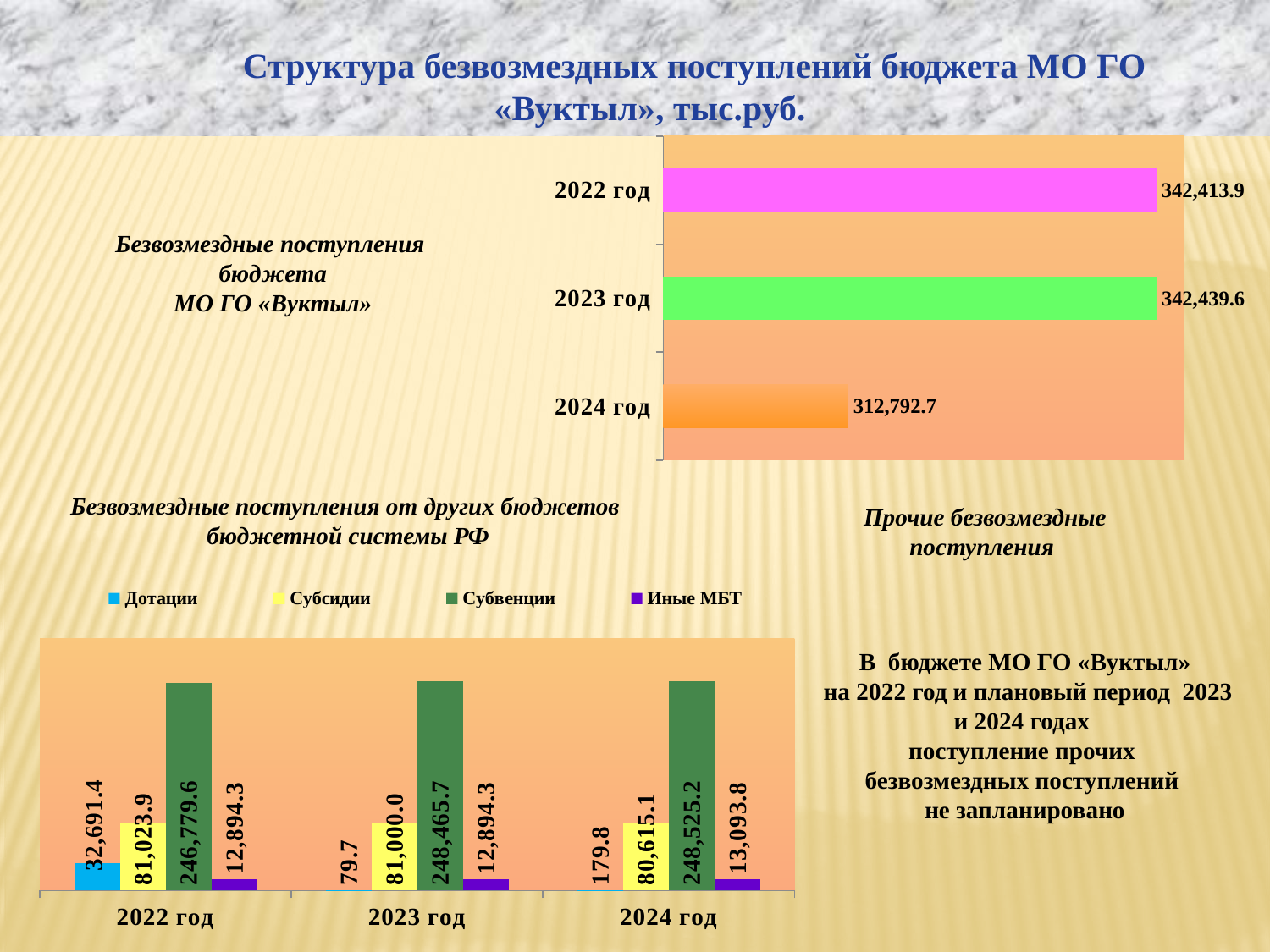
In the bottom chart (Безвозмездные поступления от других бюджетов бюджетной системы РФ), which series has the highest value in 2023 год? Субвенции In the top chart (Безвозмездные поступления бюджета МО ГО «Вуктыл»), what is the difference between the values for 2023 год and 2024 год? 29,646.9 In the bottom chart (Безвозмездные поступления от других бюджетов бюджетной системы РФ), what is the difference between Иные МБТ in 2024 год and in 2023 год? 199.5 In the bottom chart (Безвозмездные поступления от других бюджетов бюджетной системы РФ), what colour represents Субвенции in the legend? Green In the bottom chart (Безвозмездные поступления от других бюджетов бюджетной системы РФ), how many series does the legend list? 4 In the top chart (Безвозмездные поступления бюджета МО ГО «Вуктыл»), which year has the lowest value? 2024 год In the top chart (Безвозмездные поступления бюджета МО ГО «Вуктыл»), what is the value for 2023 год? 342,439.6 What type of chart is the top chart (Безвозмездные поступления бюджета МО ГО «Вуктыл»)? Bar chart In the bottom chart (Безвозмездные поступления от других бюджетов бюджетной системы РФ), what is the value of Субвенции for 2024 год? 248,525.2 In the bottom chart (Безвозмездные поступления от других бюджетов бюджетной системы РФ), which is larger for 2022 год: Субсидии or Иные МБТ? Субсидии In the top chart (Безвозмездные поступления бюджета МО ГО «Вуктыл»), how many years are shown? 3 In the bottom chart (Безвозмездные поступления от других бюджетов бюджетной системы РФ), what is the value of Дотации for 2022 год? 32,691.4